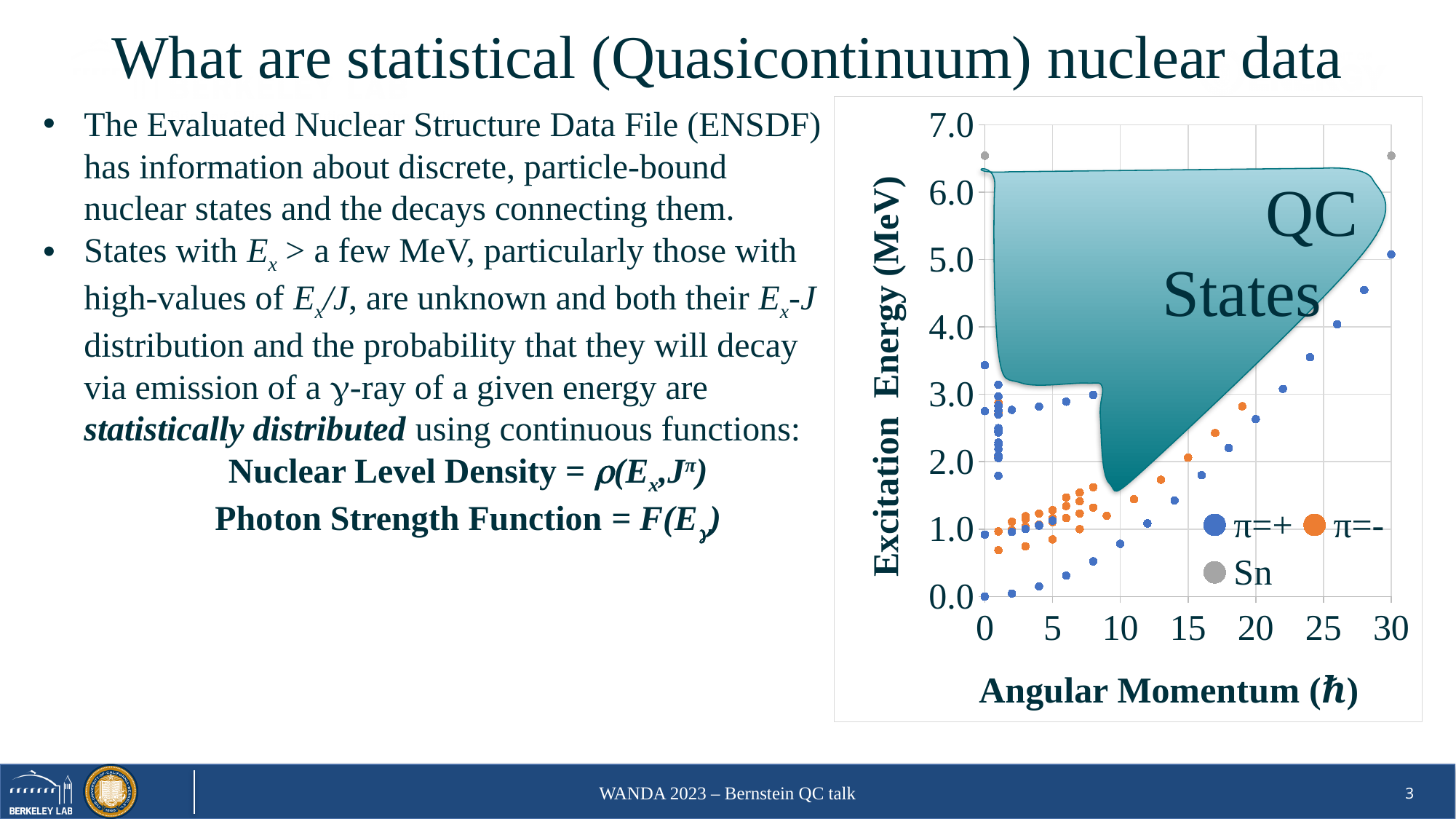
How many series does the chart legend list? 3 What is the title of the chart's horizontal axis? Angular Momentum (ħ) Which series contains the points with the highest excitation energy on the chart? Sn Do the π=+ points generally rise or fall in excitation energy as angular momentum increases from 10 to 30? rise Is the excitation energy of the π=- point near angular momentum 20 greater or less than 3.0? less Is the excitation energy of the highest π=+ point at angular momentum 30 greater or less than 4.0? greater At angular momentum 30, which series has the higher excitation energy point, Sn or π=+? Sn How many Sn (grey) points are plotted on the chart? 2 Is the excitation energy of the π=+ point near angular momentum 25 greater or less than 3.0? greater What kind of chart is shown on the slide? scatter chart What are the three series named in the chart legend? π=+, π=-, Sn